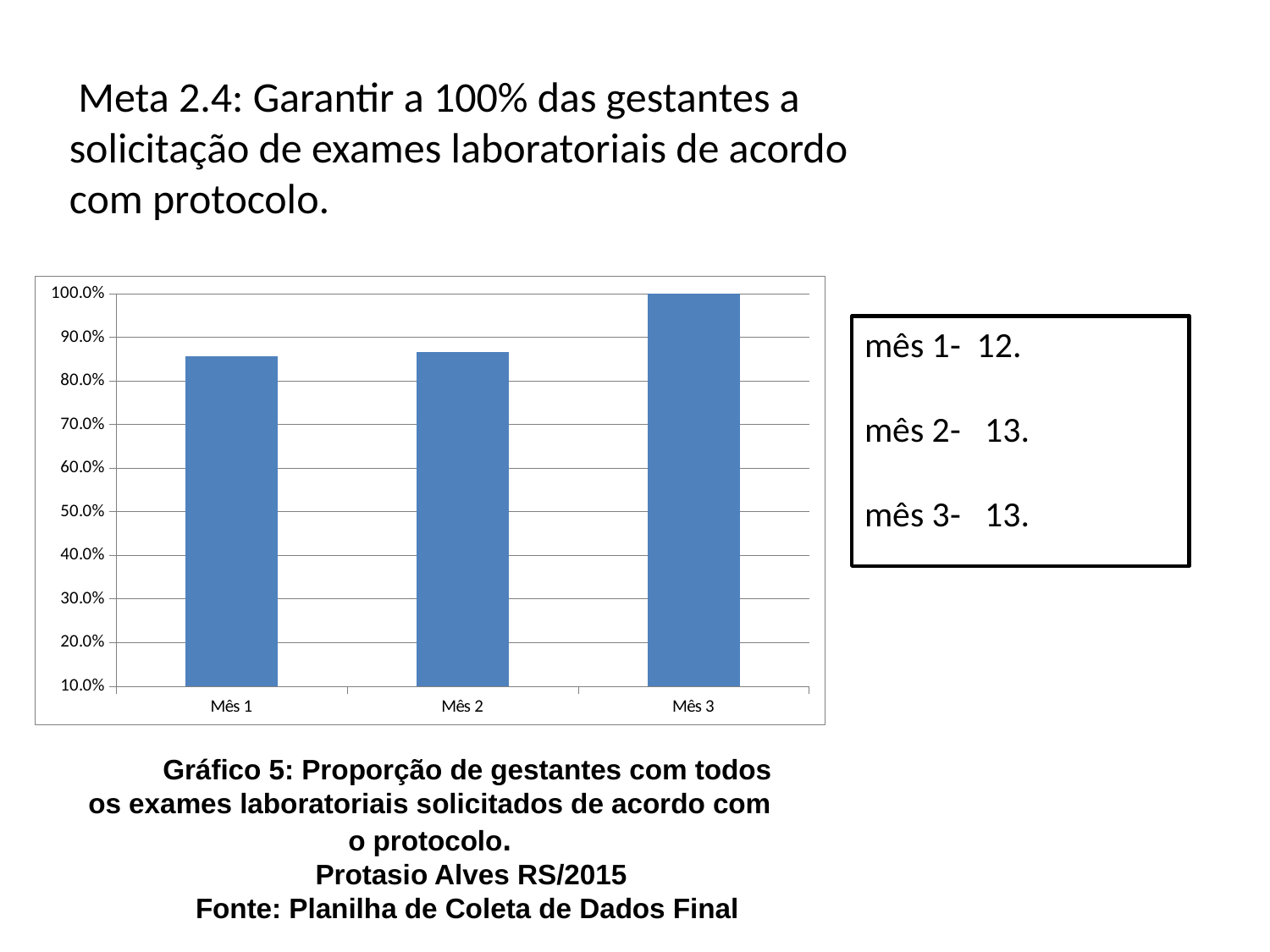
Which is larger, the value for Mês 3 or the value for Mês 1? Mês 3 Is the value for Mês 2 greater or less than 80.0%? greater Is the value for Mês 2 greater or less than 90.0%? less Is the value for Mês 1 greater or less than 80.0%? greater What is the value for Mês 3? 100.0% Which month has the highest value on the chart? Mês 3 How many categories (months) are plotted on the chart? 3 What is the lowest value shown on the vertical axis of the chart? 10.0% Do the values generally rise or fall from Mês 1 to Mês 3? rise What colour are the bars in the chart? blue What kind of chart is shown on the slide? bar chart